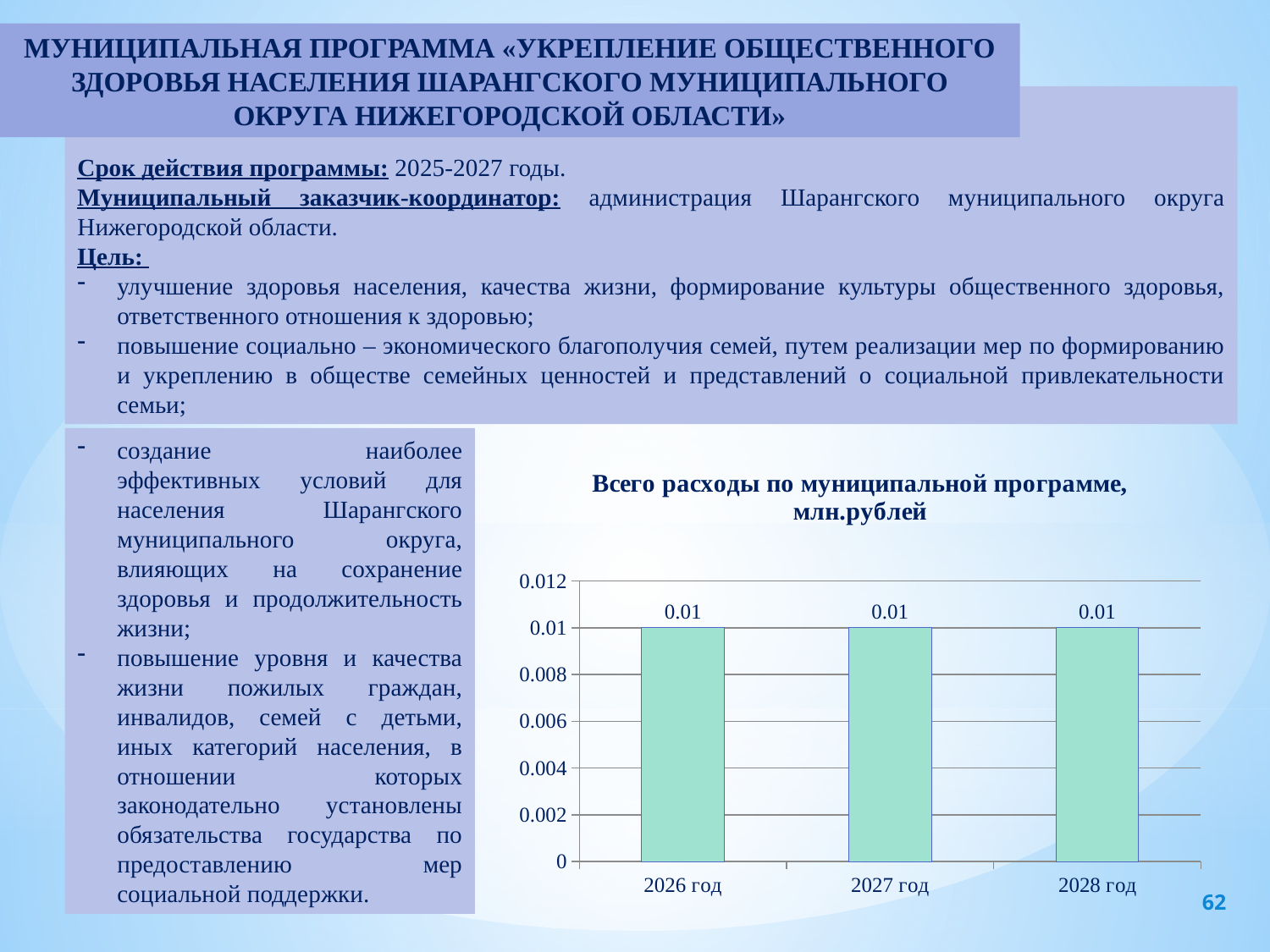
What is the value for 2027 год? 0.01 Is the value for 2027 год greater or less than 0.008? greater In what units are the chart values expressed, according to the title? млн.рублей What is the title of the chart? Всего расходы по муниципальной программе, млн.рублей What is the difference between the values for 2026 год and 2028 год? 0 How many categories (years) are shown on the x axis of the chart? 3 Is the value for 2026 год greater or less than 0.012? less What is the value for 2026 год? 0.01 What is the value for 2028 год? 0.01 What kind of chart is shown on the slide? Bar chart Do the values rise, fall, or stay the same from 2026 год to 2028 год? Stay the same